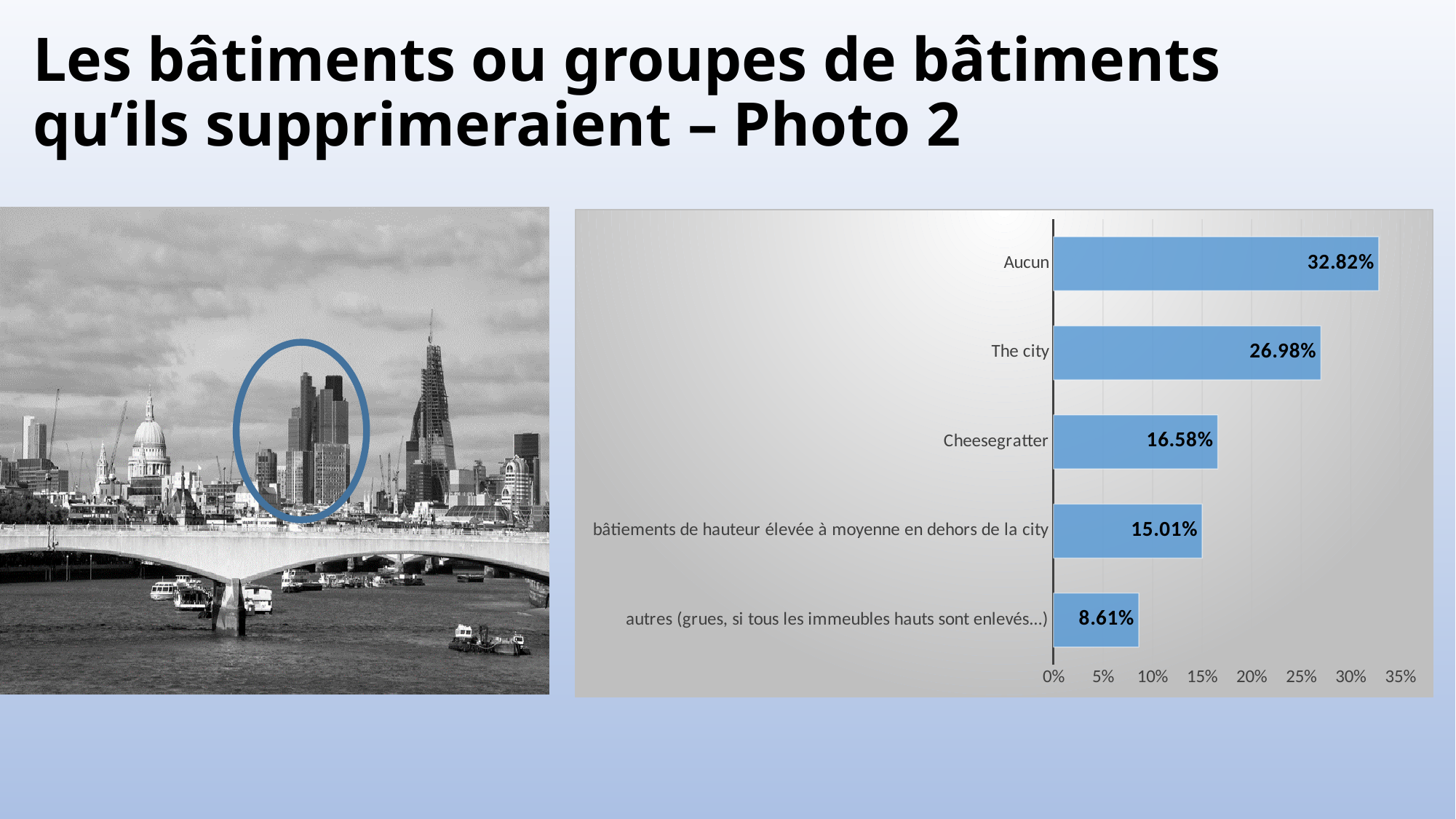
What is the value for The city? 26.98% What is the value for 'autres (grues, si tous les immeubles hauts sont enlevés...)'? 8.61% Which is larger, the value for Cheesegratter or the value for 'bâtiements de hauteur élevée à moyenne en dehors de la city'? Cheesegratter Which category has the highest value? Aucun What is the difference between the values for Aucun and The city? 5.84% What is the value for 'bâtiements de hauteur élevée à moyenne en dehors de la city'? 15.01% What is the value for Cheesegratter? 16.58% What kind of chart is shown on the slide? bar chart How many categories are shown in the chart? 5 Which category has the lowest value? autres (grues, si tous les immeubles hauts sont enlevés...) What is the value for Aucun? 32.82% Is the value for The city greater or less than 25%? greater